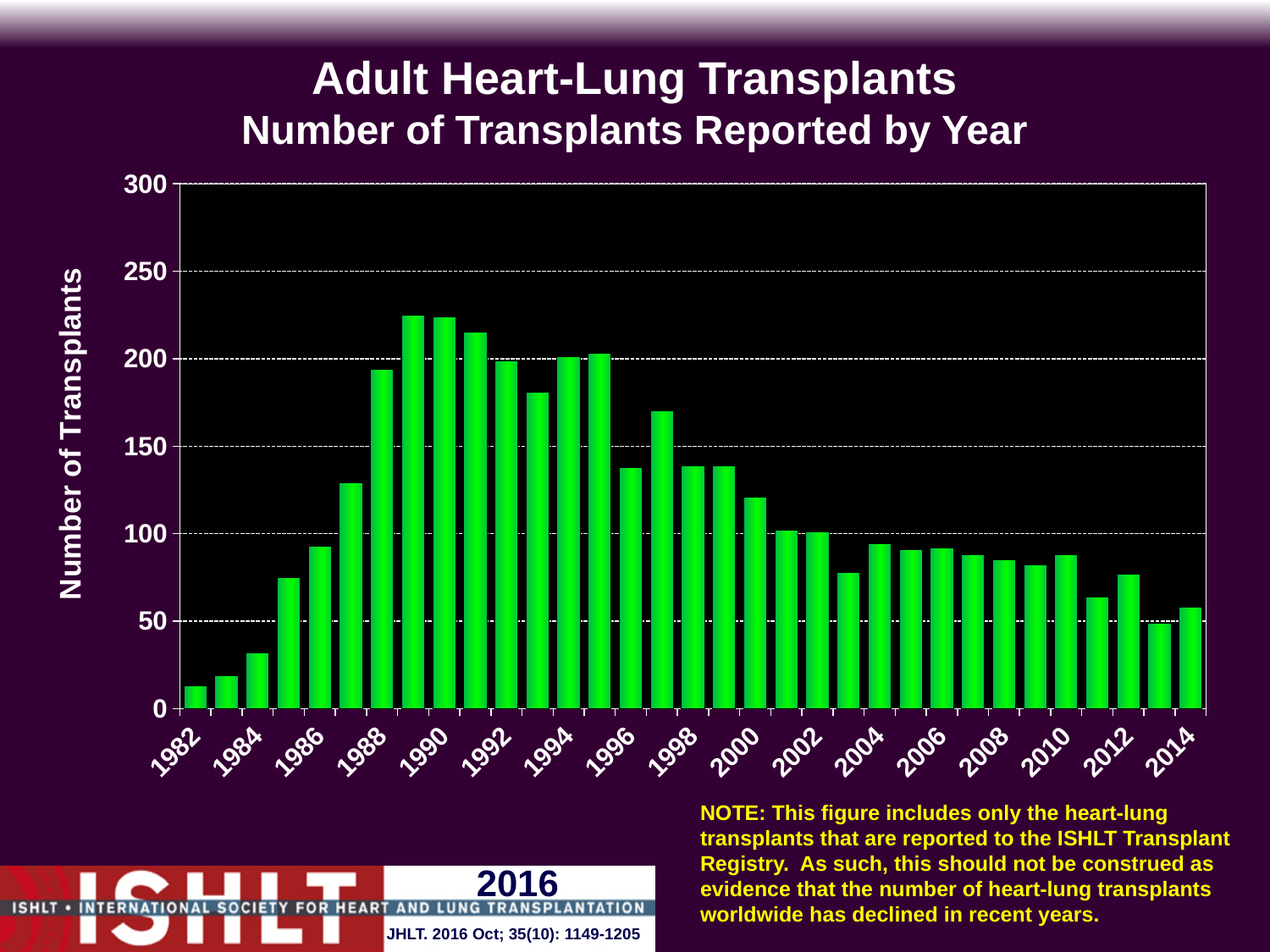
What kind of chart is shown on the slide? bar chart Is the value for 2000 greater or less than 100? greater Is the value for 1996 greater or less than 150? less Which year has the larger number of transplants, 1988 or 2008? 1988 Is the value for 1982 greater or less than 50? less What is the label of the vertical axis? Number of Transplants Which year has the lowest number of transplants? 1982 Which year has the larger number of transplants, 1984 or 2004? 2004 How many bars (years) are plotted in the chart? 33 Do the values generally rise or fall from 1982 to 1990? rise